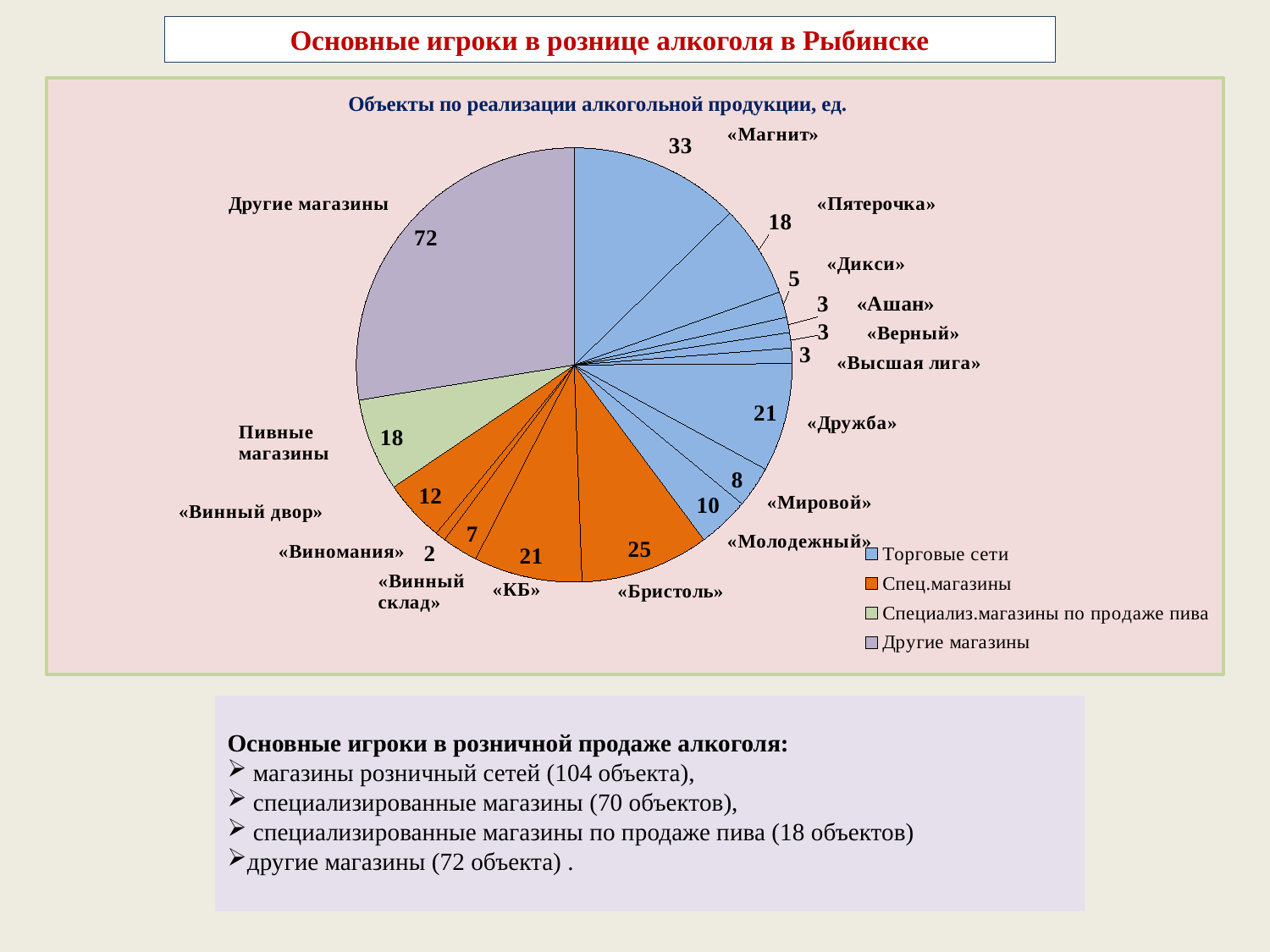
What is the title of the chart? Объекты по реализации алкогольной продукции, ед. How many slices does the pie chart have? 16 Which is larger, the value for «Дружба» or the value for «Молодежный»? «Дружба» What is the value for Пивные магазины? 18 What is the difference between the values for «Магнит» and «Пятерочка»? 15 Which slice has the smallest value? «Виномания» How many entries does the legend list? 4 What is the value for «Магнит»? 33 Which slice has the largest value? Другие магазины What is the value for «Бристоль»? 25 What is the value for «Винный двор»? 12 What type of chart is shown on the slide? pie chart